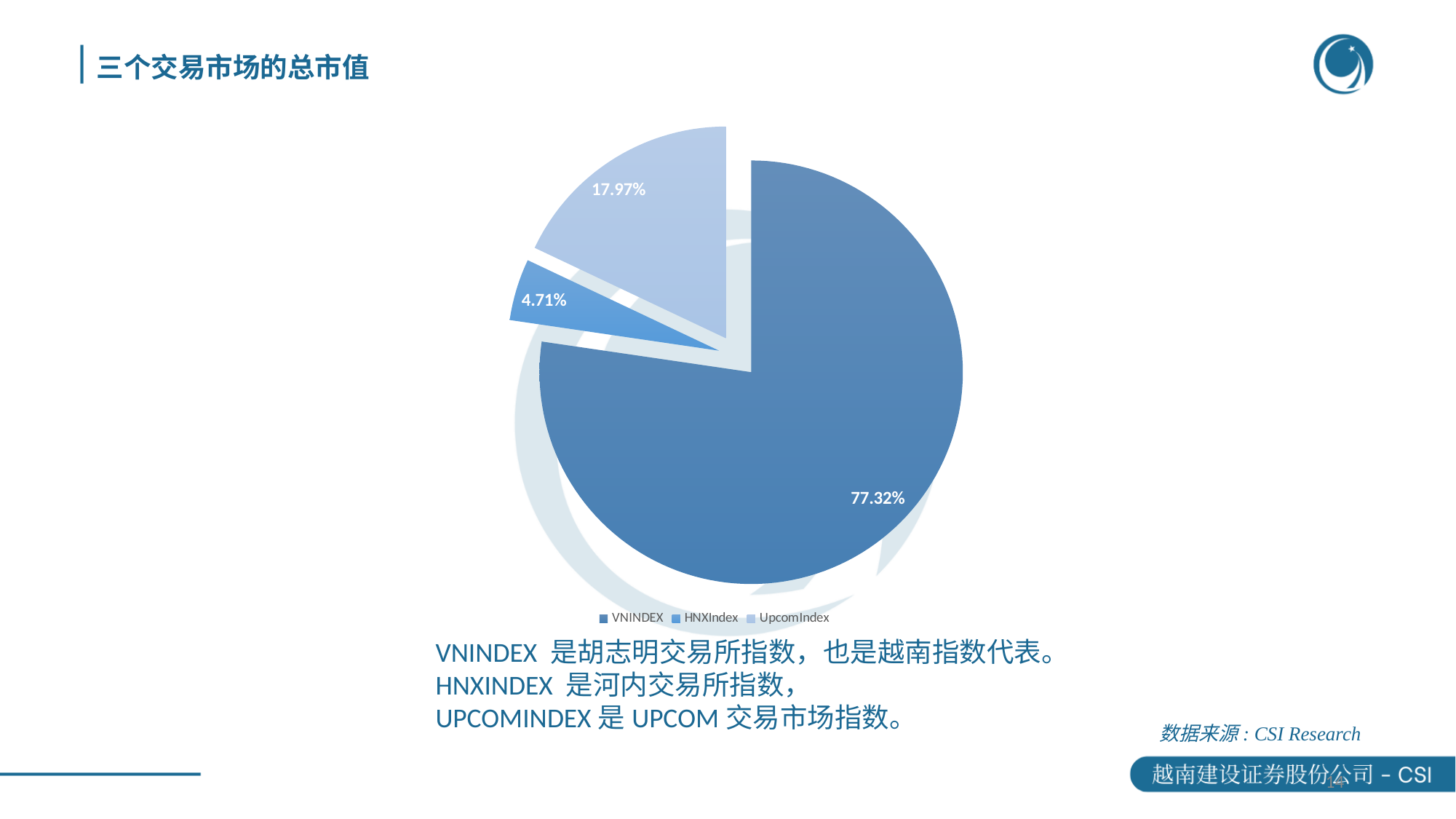
Which is larger, the share for UpcomIndex or the share for HNXIndex? UpcomIndex What is the difference in percentage points between the UpcomIndex share and the HNXIndex share? 13.26 Which slice of the pie is the largest? VNINDEX What share of the pie does UpcomIndex hold? 17.97% What is the title of the slide containing the pie chart? 三个交易市场的总市值 What share of the pie does VNINDEX hold? 77.32% What kind of chart is shown on the slide? pie chart Which slice of the pie is the smallest? HNXIndex What share of the pie does HNXIndex hold? 4.71% How many slices does the pie chart have? 3 What is the difference in percentage points between the VNINDEX share and the UpcomIndex share? 59.35 How many entries does the legend list? 3